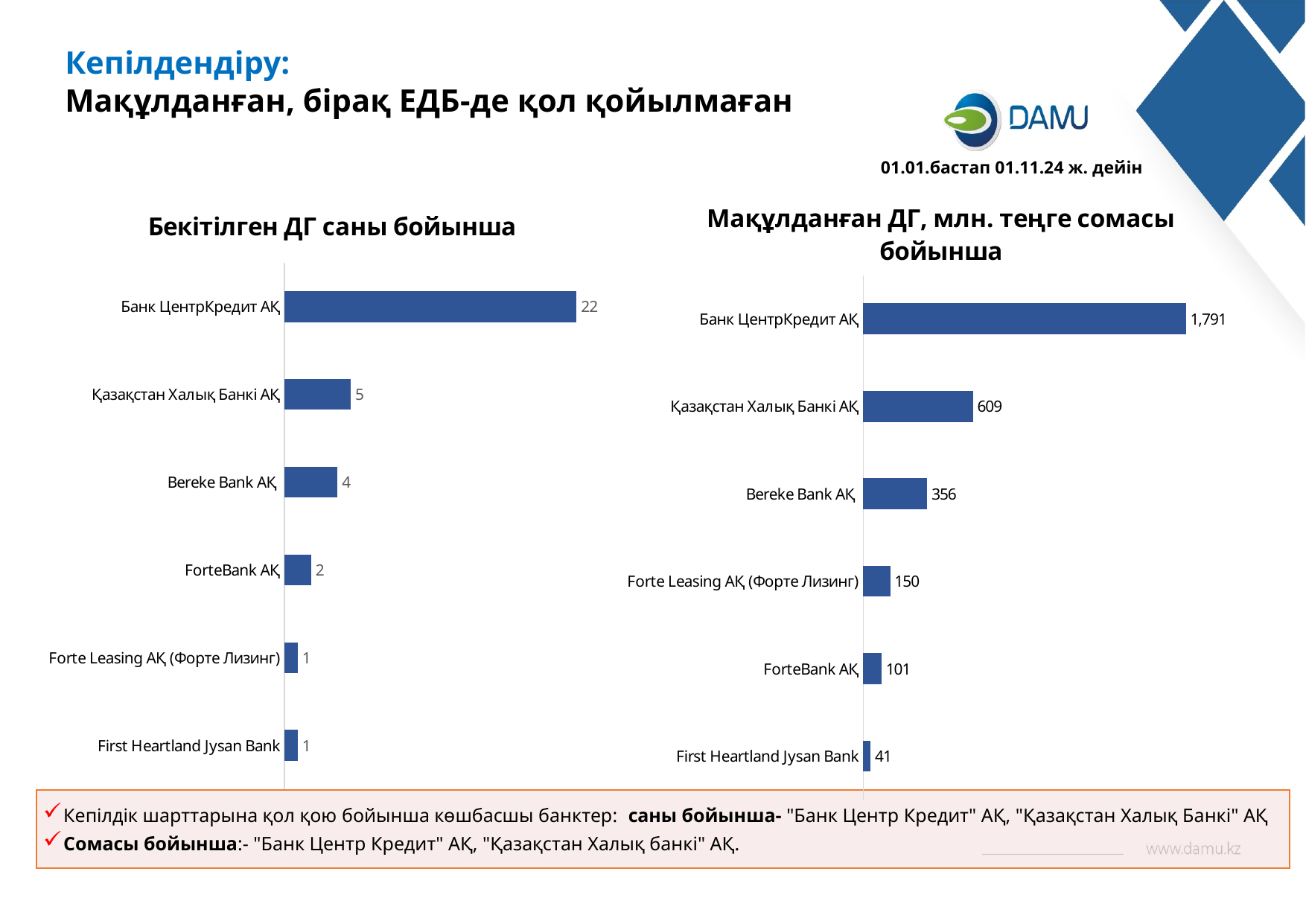
What type of chart is the right chart 'Мақұлданған ДГ, млн. теңге сомасы бойынша'? Bar chart In the right chart 'Мақұлданған ДГ, млн. теңге сомасы бойынша', what is the value for Forte Leasing АҚ (Форте Лизинг)? 150 In the left chart 'Бекітілген ДГ саны бойынша', what is the value for Банк ЦентрКредит АҚ? 22 In the left chart 'Бекітілген ДГ саны бойынша', which bank has the highest value? Банк ЦентрКредит АҚ In the right chart 'Мақұлданған ДГ, млн. теңге сомасы бойынша', what is the difference between Bereke Bank АҚ and ForteBank АҚ? 255 In the right chart 'Мақұлданған ДГ, млн. теңге сомасы бойынша', which bank has the lowest value? First Heartland Jysan Bank How many banks are shown in the left chart 'Бекітілген ДГ саны бойынша'? 6 In the left chart 'Бекітілген ДГ саны бойынша', which is larger: Bereke Bank АҚ or ForteBank АҚ? Bereke Bank АҚ In the left chart 'Бекітілген ДГ саны бойынша', what is the difference between Банк ЦентрКредит АҚ and Қазақстан Халық Банкі АҚ? 17 What is the title of the left chart? Бекітілген ДГ саны бойынша In the right chart 'Мақұлданған ДГ, млн. теңге сомасы бойынша', what is the value for Қазақстан Халық Банкі АҚ? 609 In the right chart 'Мақұлданған ДГ, млн. теңге сомасы бойынша', which is larger: Forte Leasing АҚ (Форте Лизинг) or ForteBank АҚ? Forte Leasing АҚ (Форте Лизинг)